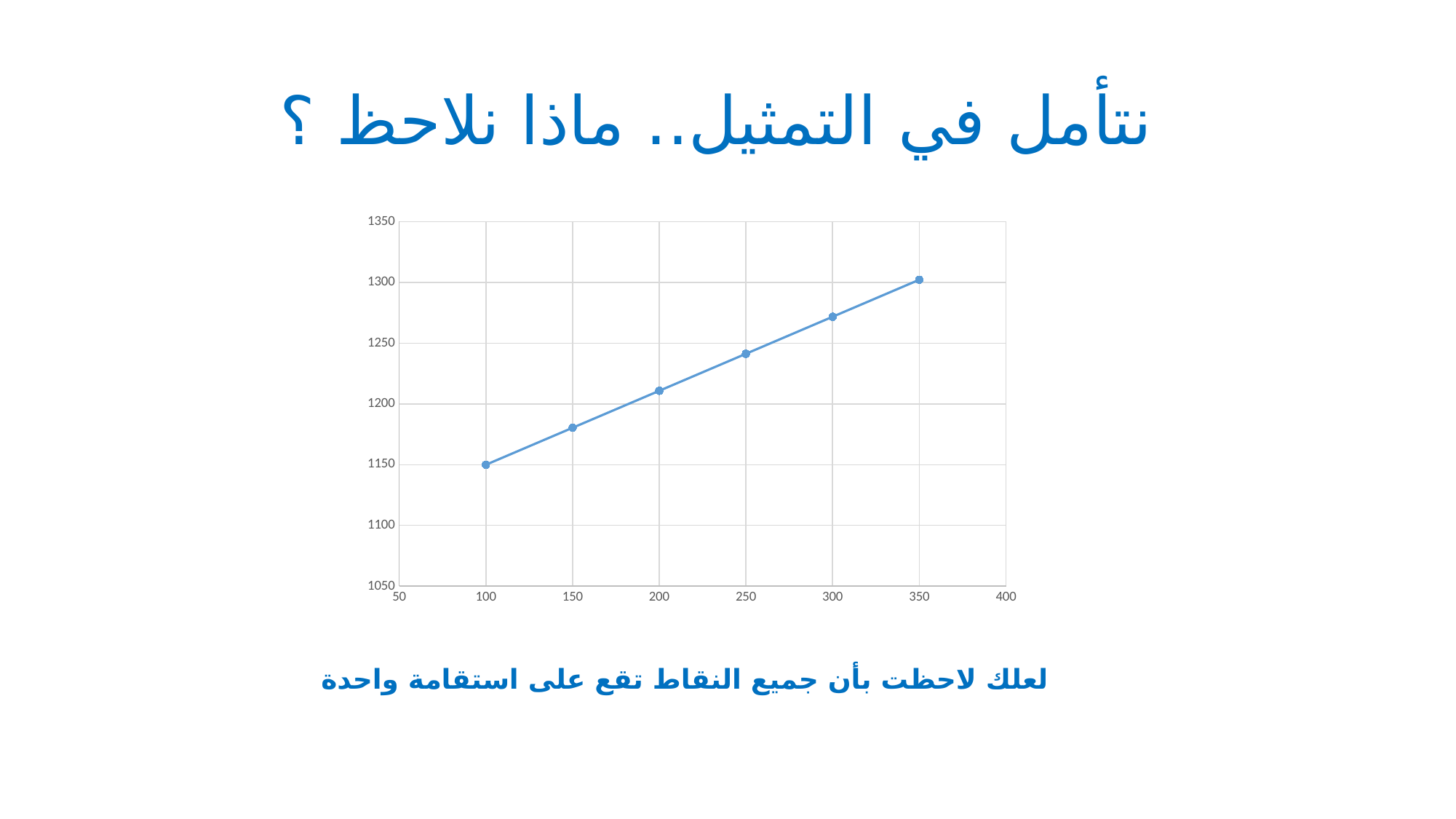
Is the y value of the point at x = 200 greater or less than 1200? greater What kind of chart is shown on the slide? line chart Is the y value of the point at x = 150 greater or less than 1200? less At which x value is the plotted y value lowest? 100 Is the y value of the point at x = 250 greater or less than 1250? less At which x value is the plotted y value highest? 350 How many data points are plotted on the chart? 6 Do the plotted values rise or fall as x increases from 100 to 350? rise